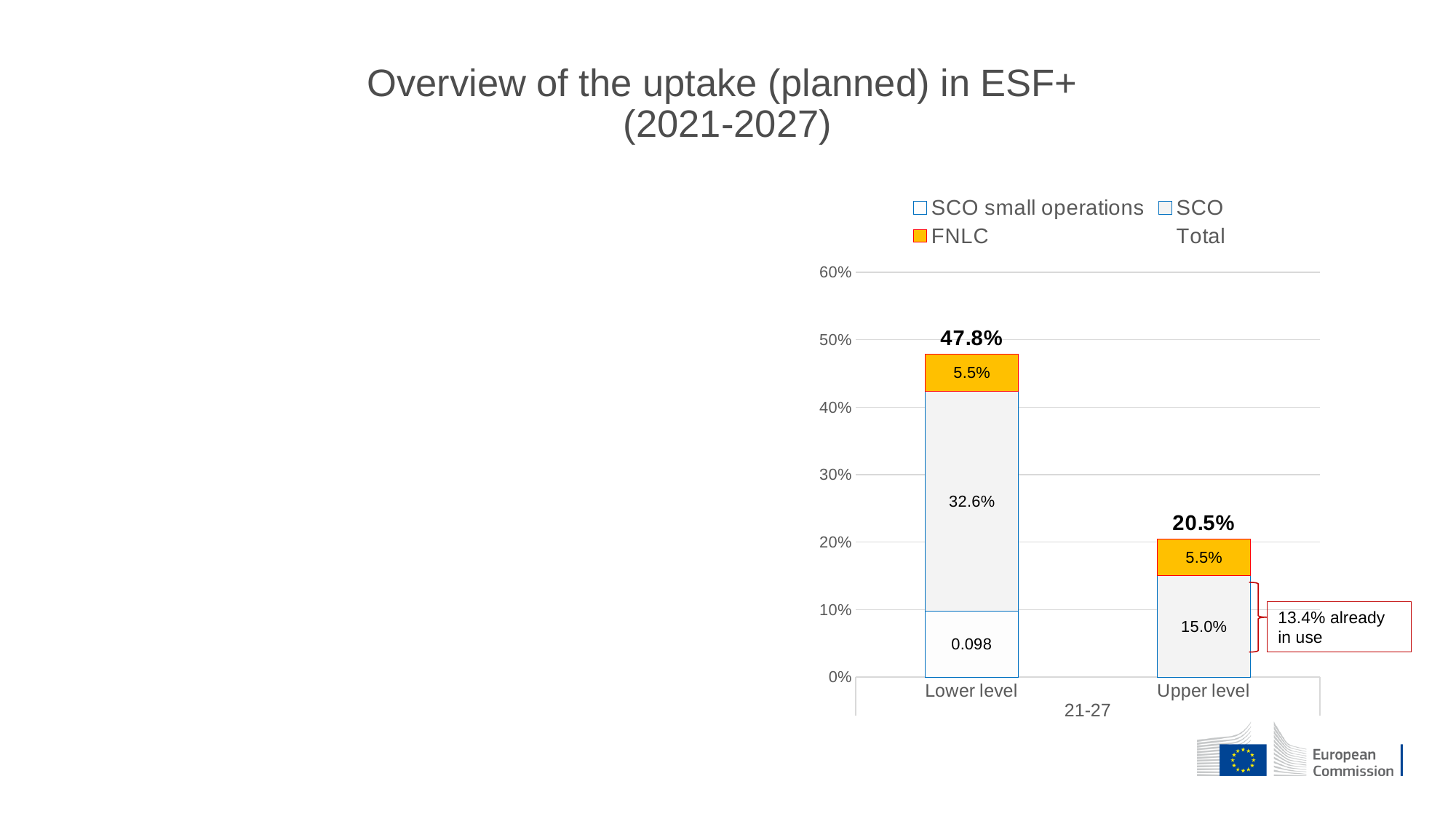
What type of chart is shown on the slide? Stacked bar chart How many categories are shown on the x axis? 2 What is the SCO small operations value labelled in the Lower level bar? 0.098 What is the total value shown above the Upper level bar? 20.5% What is the difference between the totals of the Lower level and Upper level bars? 27.3% What is the FNLC value for the Upper level bar? 5.5% Which category has the higher total, Lower level or Upper level? Lower level What is the SCO value for the Upper level bar? 15.0% What is the total value shown above the Lower level bar? 47.8% How many entries does the legend list? 4 What is the difference between the SCO values of the Lower level and Upper level bars? 17.6% What is the SCO value for the Lower level bar? 32.6%